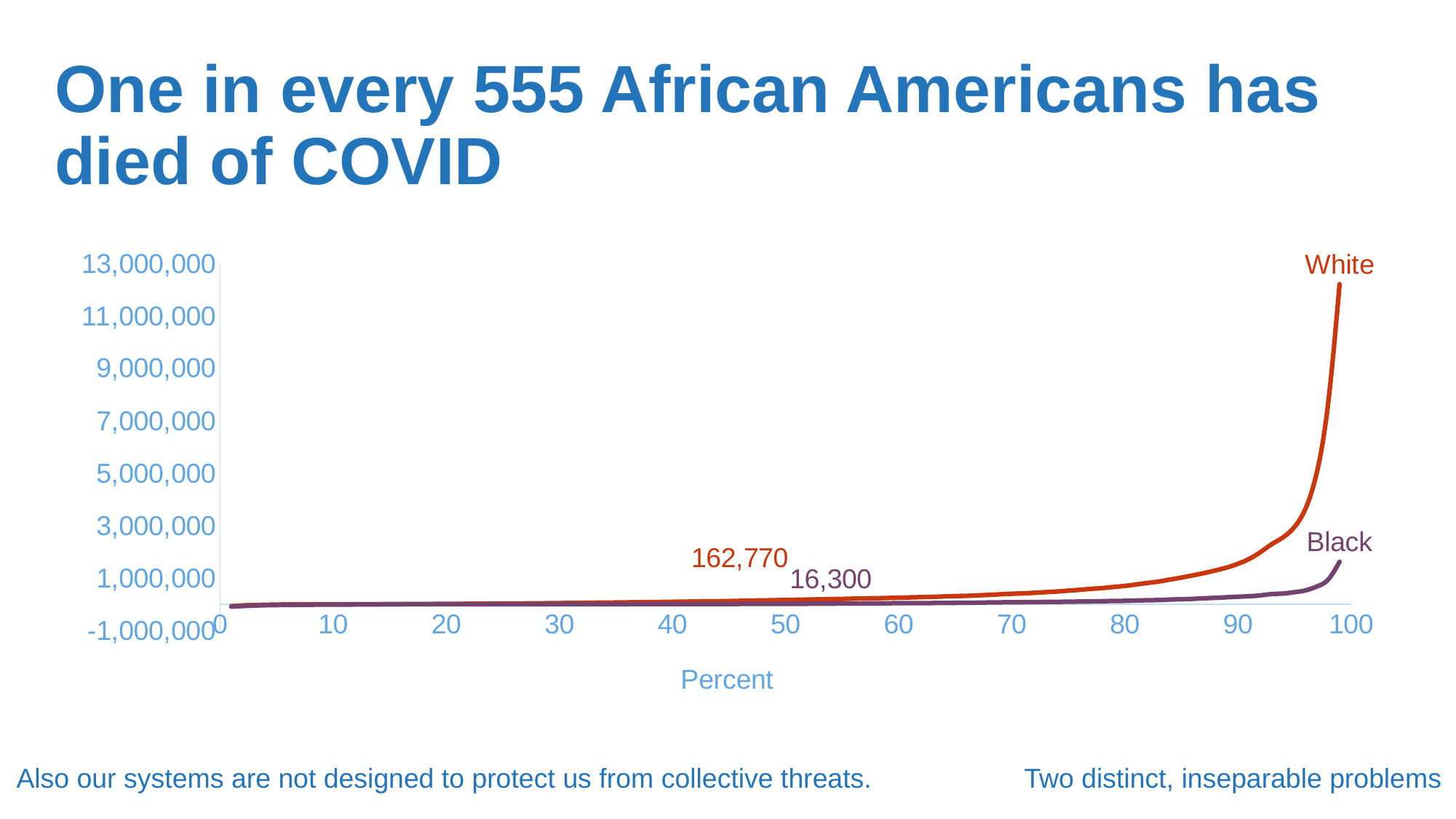
What is the difference between the labelled White value and the labelled Black value? 146,470 What is the title of the x axis? Percent Which series reaches the highest value at the right end of the chart? White What is the highest tick value shown on the y axis? 13,000,000 Which labelled value is larger, the White line's 162,770 or the Black line's 16,300? White Do the values of the White line rise or fall as the x axis moves from 0 to 100? rise What kind of chart is shown on the slide? line chart How many series are plotted on the chart? 2 Which series stays lowest across the chart? Black Is the value of the White line at its right end greater or less than 11,000,000? greater What value is labelled on the White line? 162,770 What value is labelled on the Black line? 16,300